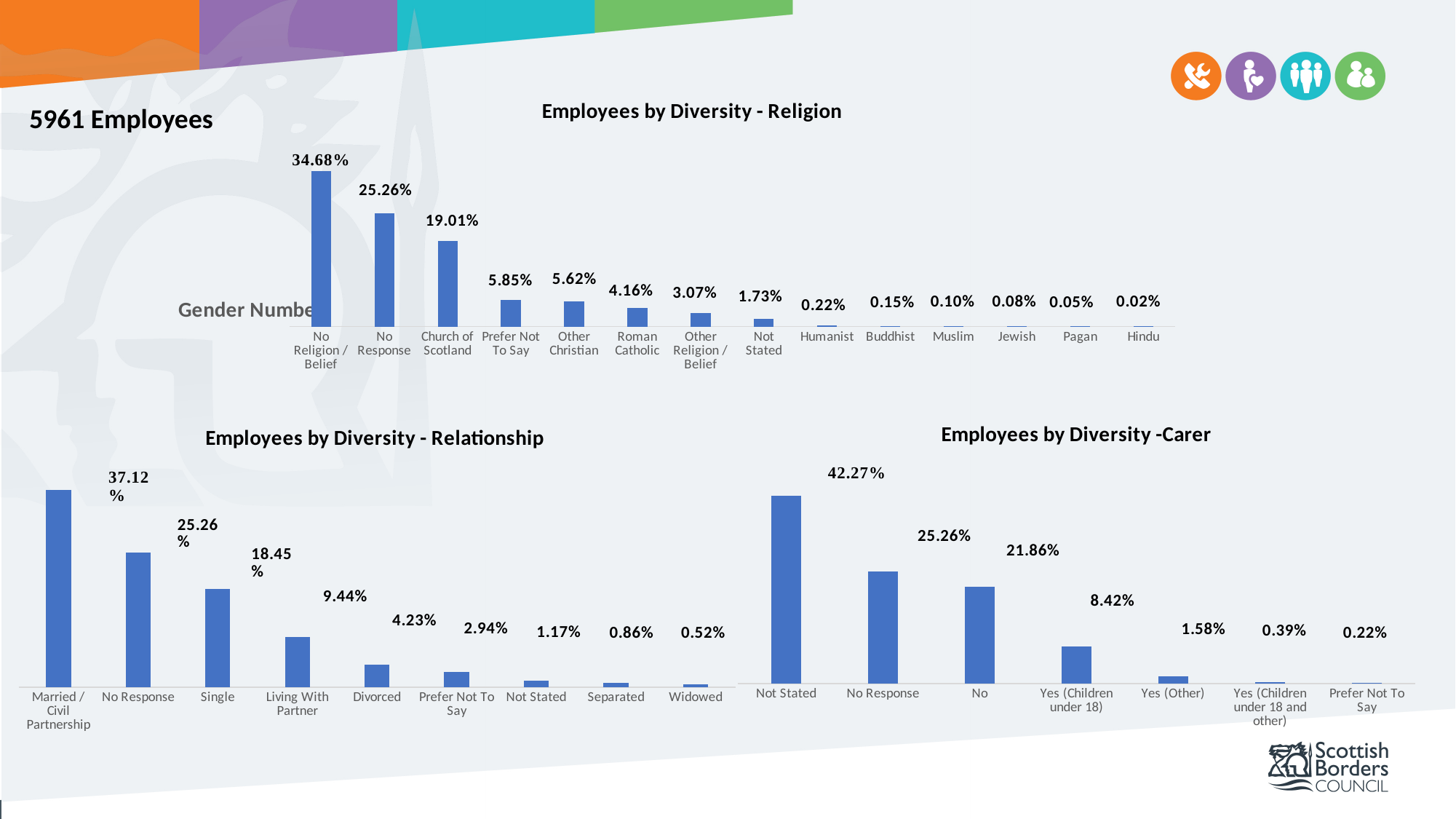
In the 'Employees by Diversity - Religion' chart, which category has the highest value? No Religion / Belief In the 'Employees by Diversity - Religion' chart, which category has the lowest value? Hindu In the 'Employees by Diversity - Relationship' chart, which category has the lowest value? Widowed In the 'Employees by Diversity - Relationship' chart, which category has the highest value? Married / Civil Partnership In the 'Employees by Diversity -Carer' chart, which is larger: No Response or No? No Response What type of chart is 'Employees by Diversity -Carer'? Bar chart In the 'Employees by Diversity - Religion' chart, what is the difference between No Religion / Belief and No Response? 9.42% In the 'Employees by Diversity -Carer' chart, what is the value for Not Stated? 42.27% In the 'Employees by Diversity - Religion' chart, what is the value for Church of Scotland? 19.01% In the 'Employees by Diversity - Religion' chart, how many categories are shown? 14 In the 'Employees by Diversity - Relationship' chart, how many categories are shown? 9 In the 'Employees by Diversity - Religion' chart, what is the value for Roman Catholic? 4.16%